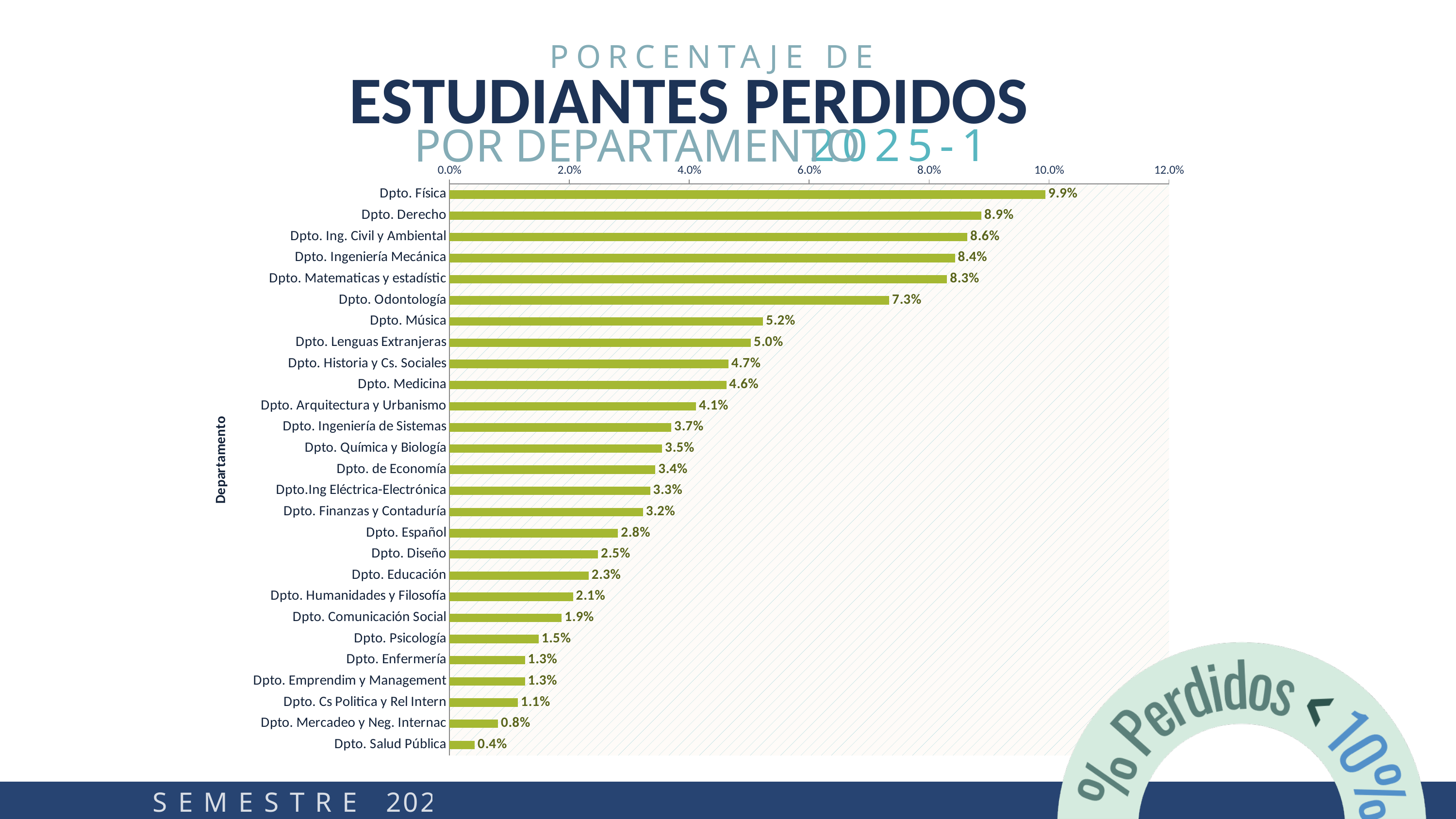
What is the label of the vertical axis? Departamento How many departments are shown in the chart? 27 What is the difference between the values for Dpto. Física and Dpto. Derecho? 1.0% Which is larger, the value for Dpto. Medicina or the value for Dpto. Diseño? Dpto. Medicina What kind of chart is shown on the slide? Bar chart What is the value for Dpto. Odontología? 7.3% What is the value for Dpto. Psicología? 1.5% Which department has the highest percentage? Dpto. Física What is the difference between the values for Dpto. Música and Dpto. Español? 2.4% What is the value for Dpto. Ingeniería de Sistemas? 3.7% What is the value for Dpto. Física? 9.9% Which department has the lowest percentage? Dpto. Salud Pública